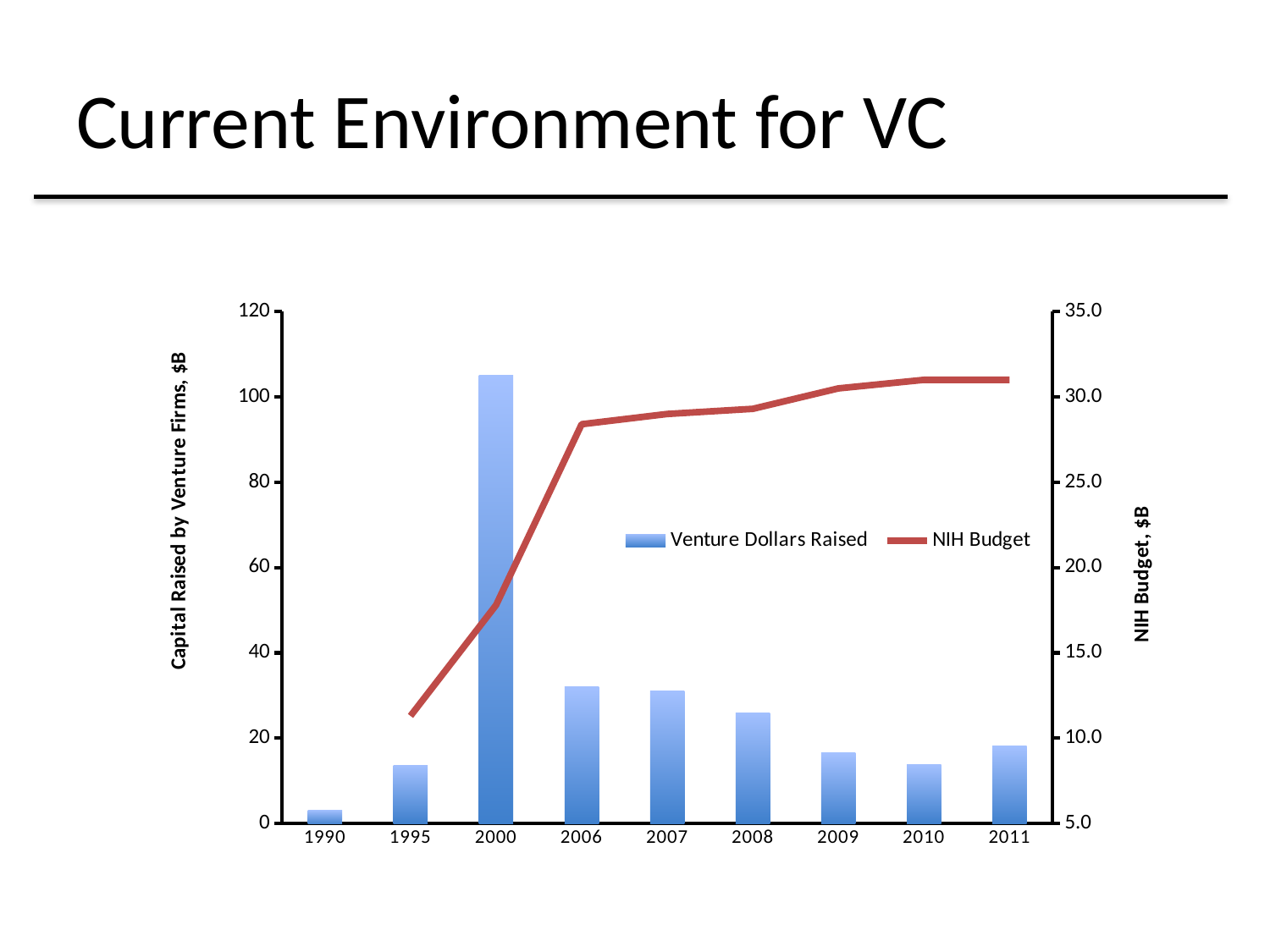
Does the NIH Budget line rise or fall from 1995 to 2011? Rises Which year has the lowest value for Venture Dollars Raised? 1990 How many series does the legend list? 2 Which year has the larger Venture Dollars Raised value, 2008 or 2009? 2008 Is the Venture Dollars Raised value for 1995 greater or less than 20? less What kind of chart is shown on the slide? A combination bar and line chart Is the NIH Budget value for 1995 greater or less than 15.0? less Is the NIH Budget value for 2011 greater or less than 30.0? greater How many years are shown on the x axis? 9 Which year has the highest value for Venture Dollars Raised? 2000 What is the title of the right-hand vertical axis? NIH Budget, $B